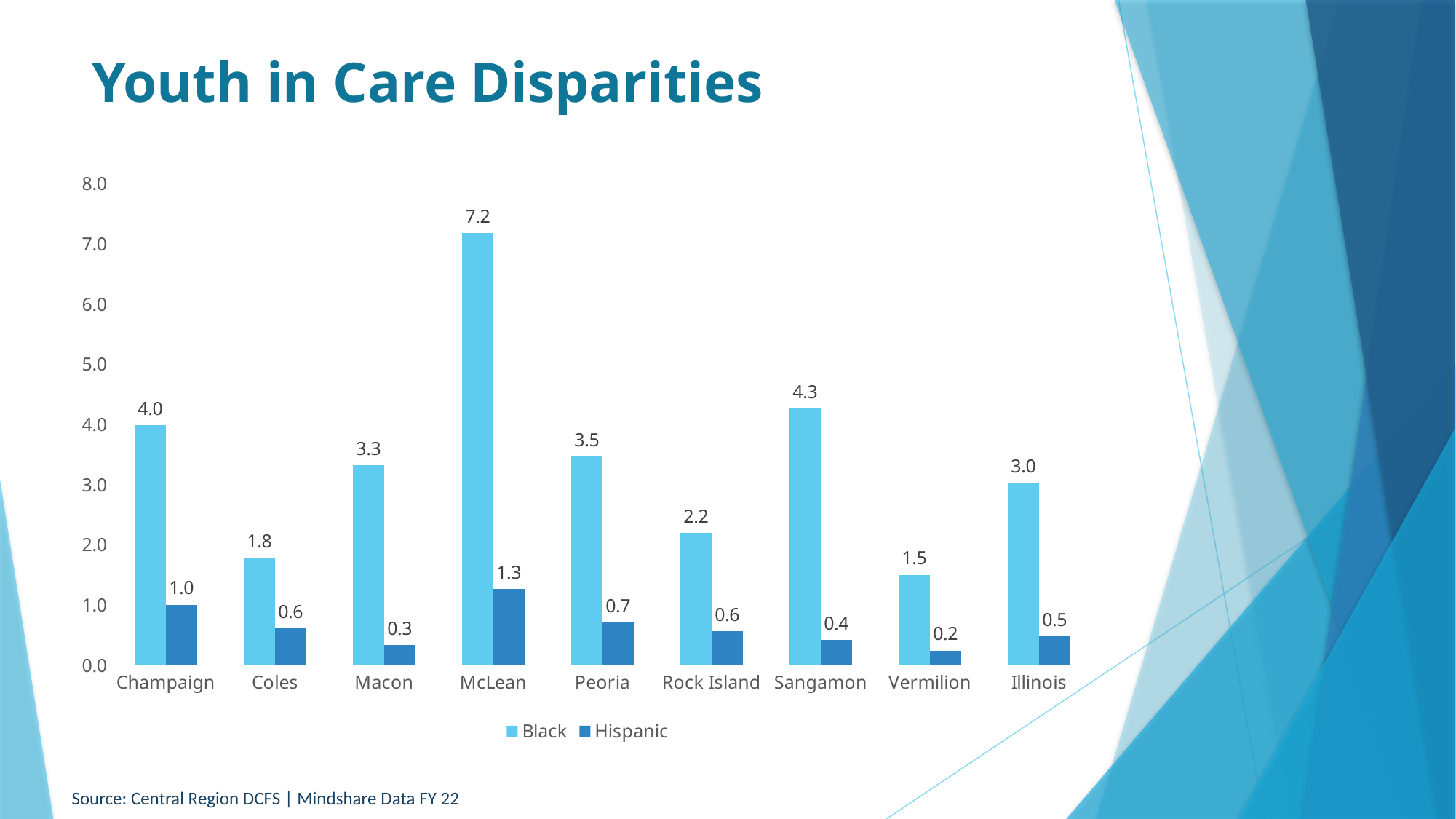
What is the Hispanic value for Champaign? 1.0 What is the Black value for Illinois? 3.0 What is the Hispanic value for Rock Island? 0.6 How many categories are shown on the x axis? 9 Which category has the highest Black value? McLean What is the difference between the Black and Hispanic values for Sangamon? 3.9 What is the title of the slide? Youth in Care Disparities What is the Black value for McLean? 7.2 What kind of chart is shown on the slide? Bar chart How many series does the legend list? 2 Which category has the lowest Hispanic value? Vermilion Which is larger, the Black value for Peoria or the Black value for Macon? Peoria